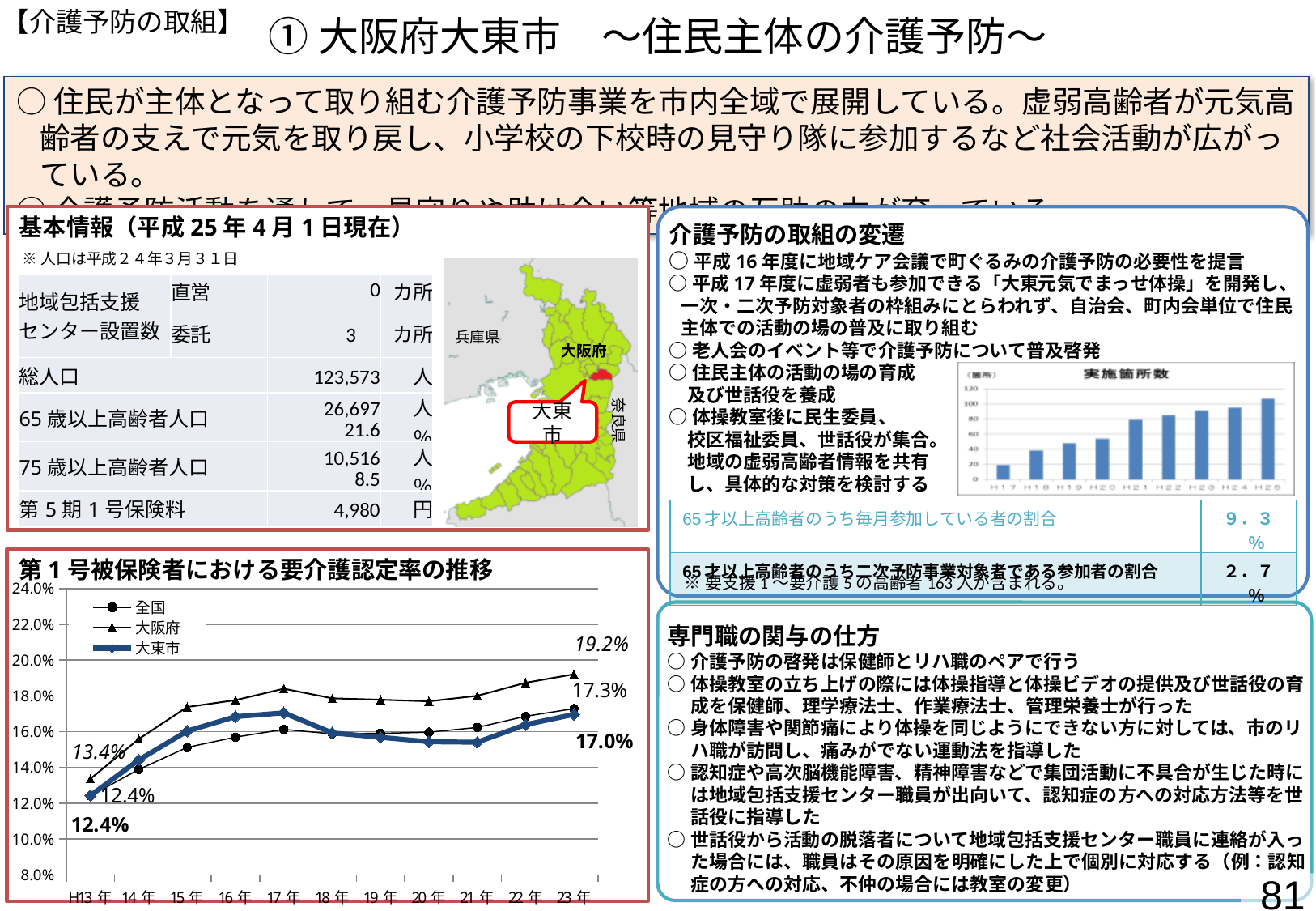
In the 実施箇所数 chart, is the value for H17 greater or less than 40? less In the 第1号被保険者における要介護認定率の推移 chart, does the 大東市 line rise or fall overall from H13年 to 23年? rise In the 第1号被保険者における要介護認定率の推移 chart, what is the value for 大阪府 in 23年? 19.2% How many series does the legend of the 第1号被保険者における要介護認定率の推移 chart list? 3 In the 第1号被保険者における要介護認定率の推移 chart, what is the difference between 大阪府 and 大東市 in 23年? 2.2% In the 実施箇所数 chart, which year has the highest value? H25 What kind of chart is the 第1号被保険者における要介護認定率の推移 chart at the bottom left? line chart In the 第1号被保険者における要介護認定率の推移 chart, what is the value for 大阪府 in H13年? 13.4% What kind of chart is the 実施箇所数 chart on the right side of the slide? bar chart In the 第1号被保険者における要介護認定率の推移 chart, what is the value for 大東市 in 23年? 17.0% In the 第1号被保険者における要介護認定率の推移 chart, which series has the highest value in 23年? 大阪府 How many years are shown on the x axis of the 第1号被保険者における要介護認定率の推移 chart? 11